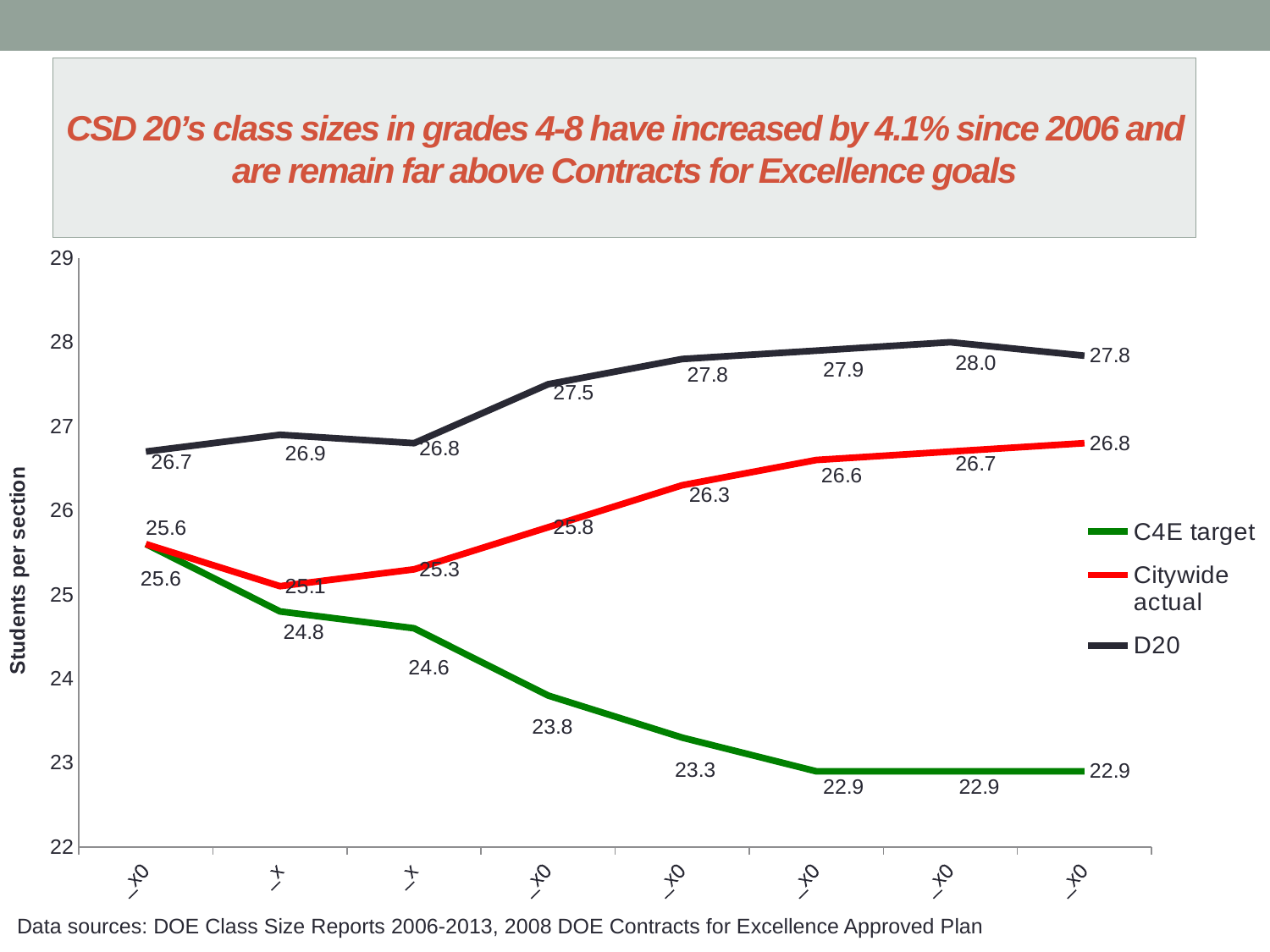
What is the label of the vertical axis? Students per section What is the difference between the last D20 value and the last C4E target value? 4.9 How many series does the legend list? 3 At the rightmost point, which is larger: D20 or Citywide actual? D20 What type of chart is shown on the slide? line chart What is the value of the last (rightmost) point on the Citywide actual line? 26.8 What is the value of the first (leftmost) point on the C4E target line? 25.6 How many data points does the D20 line have? 8 What is the value of the last (rightmost) point on the D20 line? 27.8 What is the lowest value on the Citywide actual line? 25.1 Does the C4E target line rise or fall from left to right? fall What is the highest value on the D20 line? 28.0